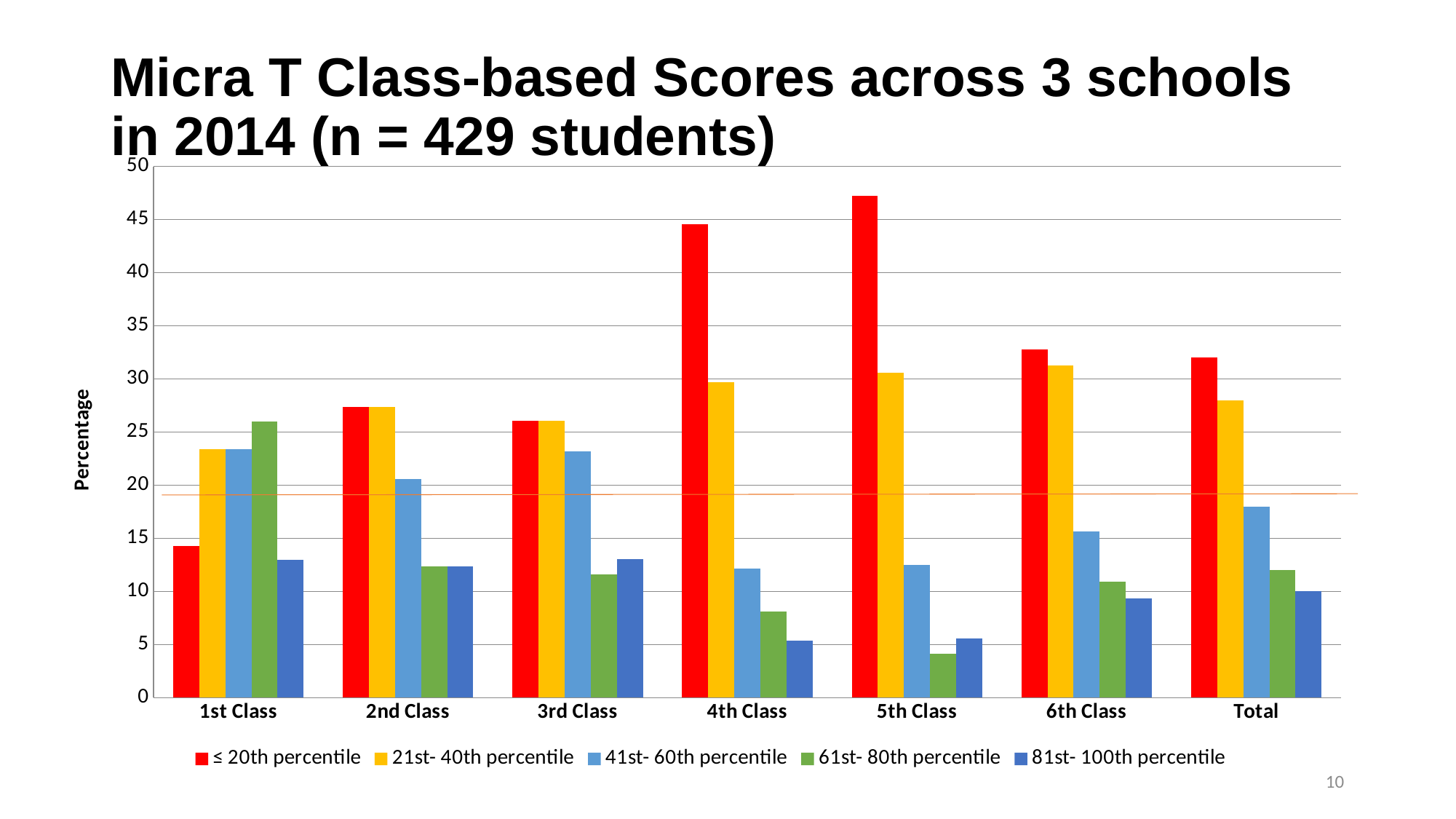
Is the value for the 81st- 100th percentile series in 5th Class greater or less than 10? less How many series does the legend list? 5 How many categories are shown on the x axis? 7 Which class has the highest bar for the ≤ 20th percentile series? 5th Class Which class has the lowest bar for the 61st- 80th percentile series? 5th Class In 1st Class, which is larger: the ≤ 20th percentile bar or the 61st- 80th percentile bar? 61st- 80th percentile What kind of chart is shown on the slide? bar chart In 1st Class, which series has the highest bar? 61st- 80th percentile Is the value for the 41st- 60th percentile series in Total greater or less than 20? less Which class has the lowest bar for the ≤ 20th percentile series? 1st Class Is the value for the ≤ 20th percentile series in 4th Class greater or less than 40? greater What is the label on the vertical axis? Percentage